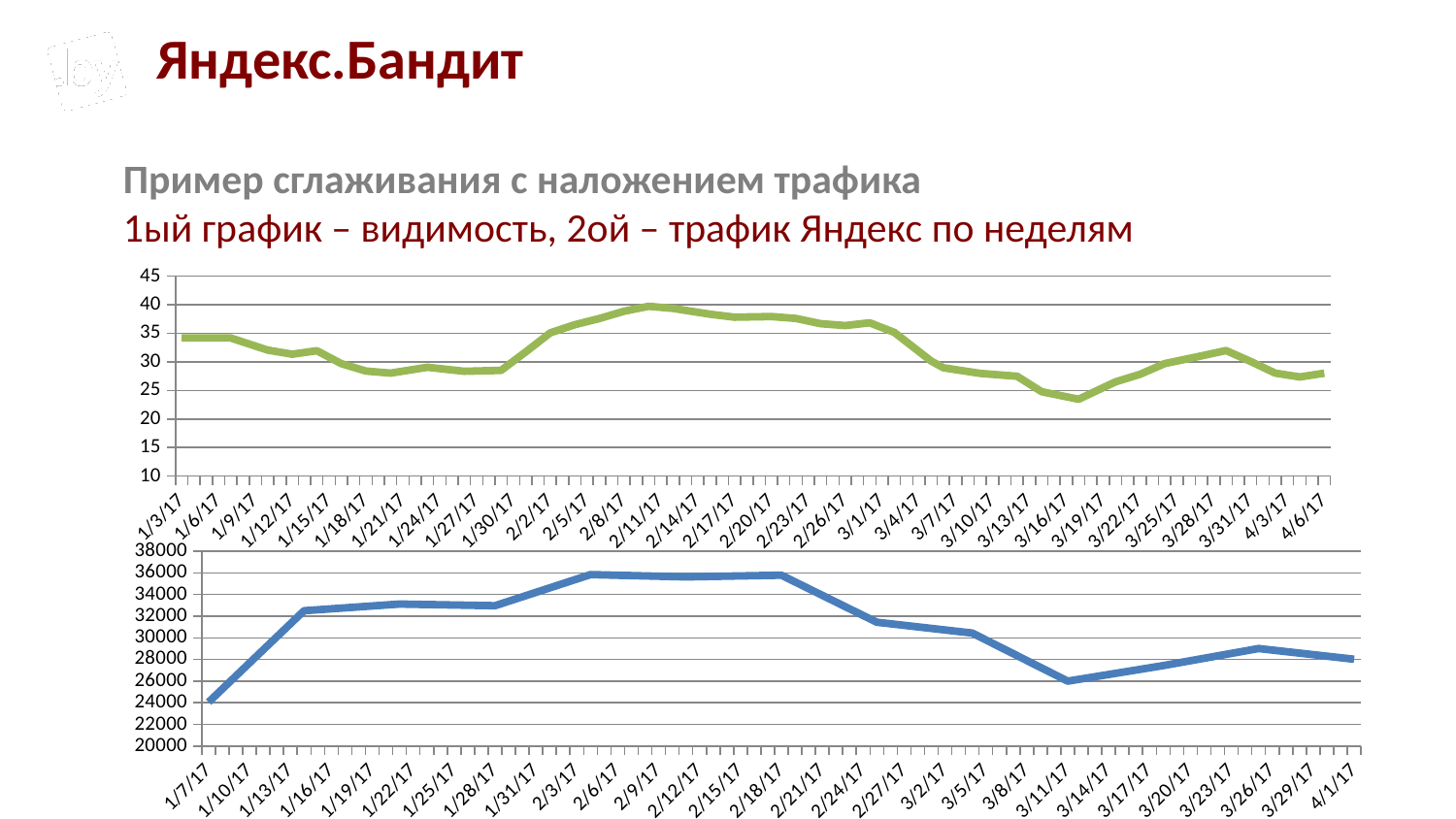
On the top chart, is the value for 3/16/17 greater or less than 25? less On the bottom chart, is the value for 1/7/17 greater or less than 26000? less On the bottom chart, do the values rise or fall from 2/18/17 to 3/11/17? fall On the top chart, which is larger, the value for 2/8/17 or the value for 3/16/17? 2/8/17 What kind of chart is the bottom chart (трафик Яндекс по неделям)? line chart On the bottom chart, is the value for 2/6/17 greater or less than 34000? greater On the bottom chart, which date has the lowest value? 1/7/17 What kind of chart is the top chart (видимость)? line chart What colour is the line on the bottom chart? blue